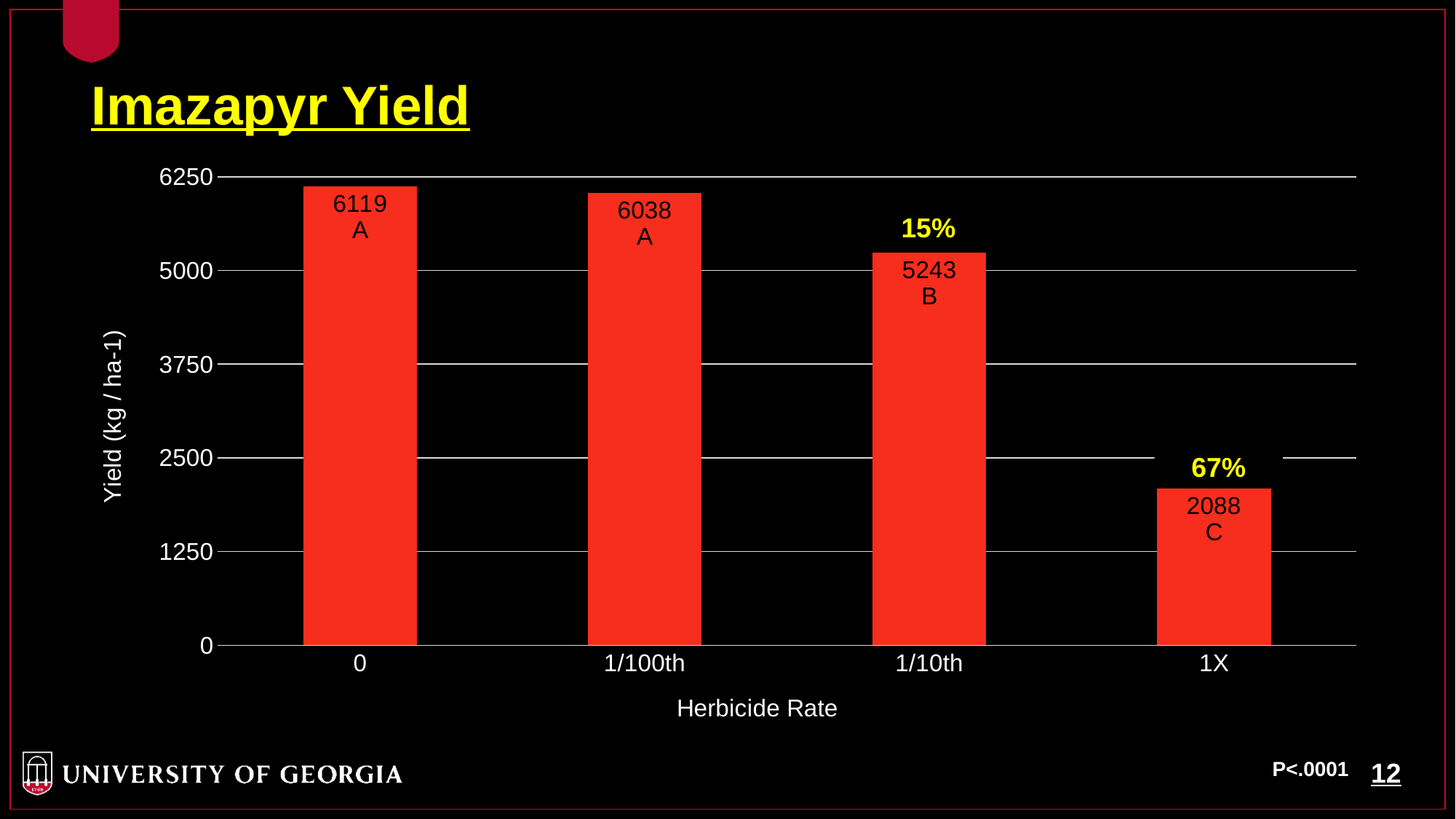
What is the yield for the 1X herbicide rate? 2088 Which has a larger yield, the 1/10th rate or the 1X rate? 1/10th Which herbicide rate has the lowest yield? 1X Which herbicide rate has the highest yield? 0 What is the yield for the 1/10th herbicide rate? 5243 What kind of chart is shown on the slide? Bar chart What is the yield for the 0 herbicide rate? 6119 What is the yield for the 1/100th herbicide rate? 6038 Do the yield values rise or fall as the herbicide rate increases along the x axis? Fall What is the difference in yield between the 1/100th rate and the 1/10th rate? 795 What is the difference in yield between the 0 rate and the 1X rate? 4031 How many herbicide rates are shown on the x axis? 4